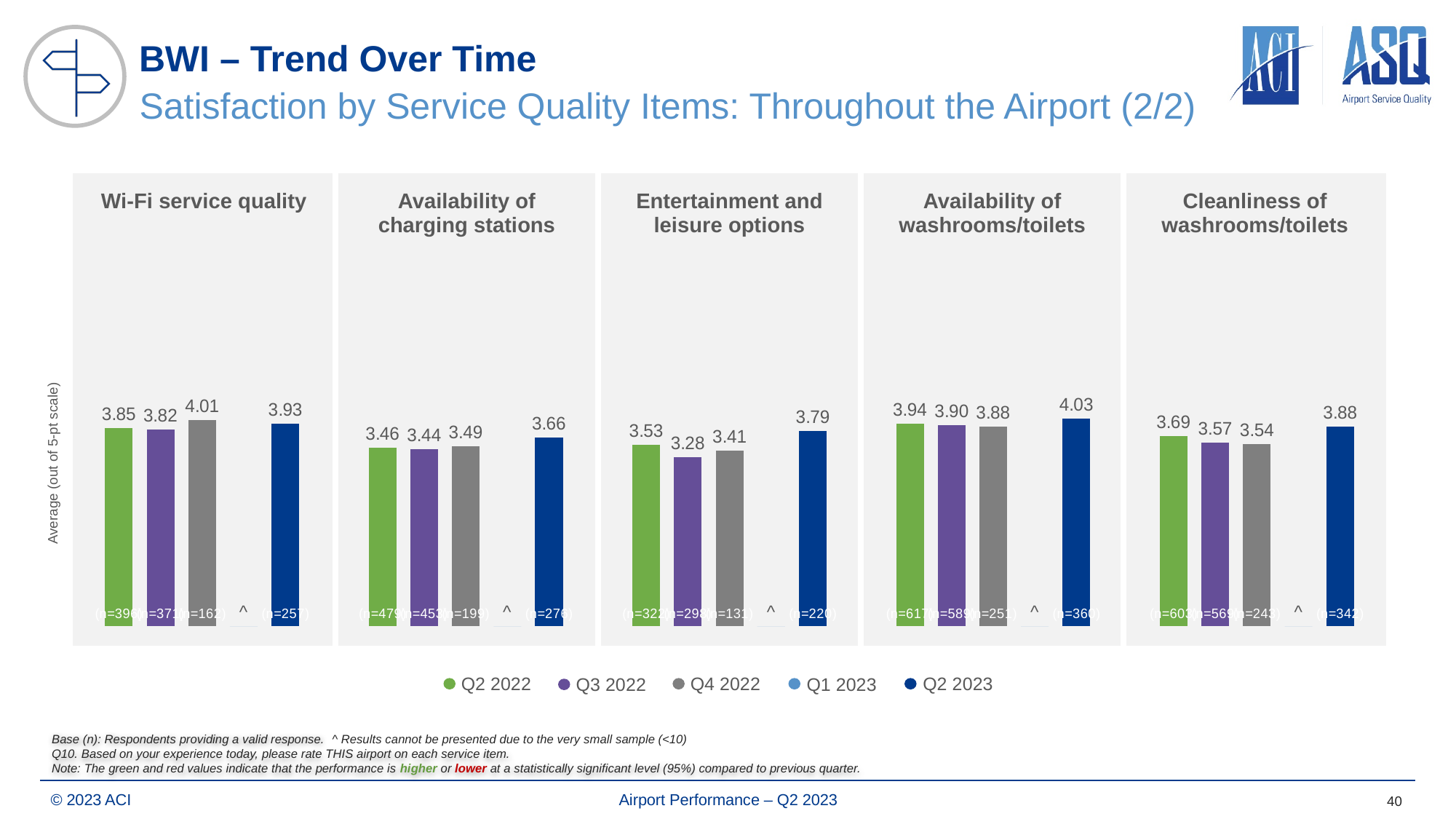
In the Entertainment and leisure options chart, which quarter has the lowest value? Q3 2022 In the Entertainment and leisure options chart, what is the difference between the Q2 2023 and Q2 2022 values? 0.26 In the Availability of charging stations chart, what is the value for Q3 2022? 3.44 In the Wi-Fi service quality chart, which is larger: the value for Q4 2022 or the value for Q2 2023? Q4 2022 Which legend entry is shown in dark blue? Q2 2023 In the Availability of washrooms/toilets chart, what is the value for Q4 2022? 3.88 In the Availability of washrooms/toilets chart, which quarter has the highest value? Q2 2023 In the Cleanliness of washrooms/toilets chart, what is the difference between the Q2 2023 and Q4 2022 values? 0.34 How many series does the legend list? 5 What kind of chart is used on this slide? Bar chart In the Wi-Fi service quality chart, what is the value for Q2 2023? 3.93 In the Cleanliness of washrooms/toilets chart, which is larger: the value for Q2 2022 or the value for Q3 2022? Q2 2022